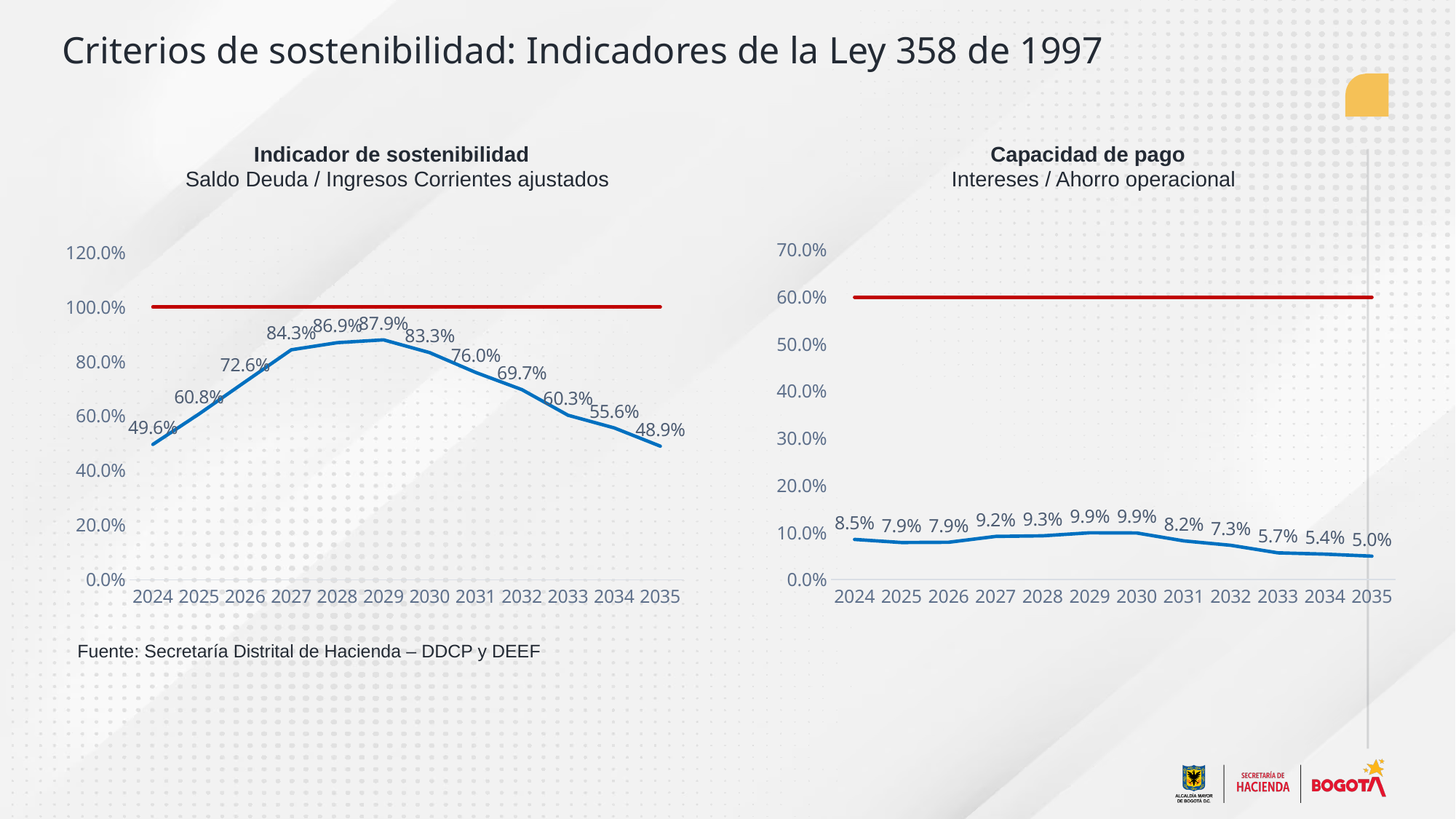
What kind of chart is the 'Indicador de sostenibilidad' chart? Line chart In the 'Capacidad de pago' chart, which is larger, the value for 2027 or the value for 2033? 2027 In the 'Capacidad de pago' chart, what is the value for 2024? 8.5% In the 'Indicador de sostenibilidad' chart, what is the difference between the values for 2029 and 2035? 39.0% In the 'Capacidad de pago' chart, which year has the lowest value on the blue line? 2035 In the 'Capacidad de pago' chart, what is the value for 2035? 5.0% In the 'Indicador de sostenibilidad' chart, what is the value for 2024? 49.6% How many years are plotted on the x axis of the 'Capacidad de pago' chart? 12 In the 'Indicador de sostenibilidad' chart, which year has the lowest value on the blue line? 2035 In the 'Indicador de sostenibilidad' chart, is the value for 2027 greater or less than 80.0%? greater In the 'Indicador de sostenibilidad' chart, which year has the highest value on the blue line? 2029 In the 'Indicador de sostenibilidad' chart, what is the value for 2029? 87.9%